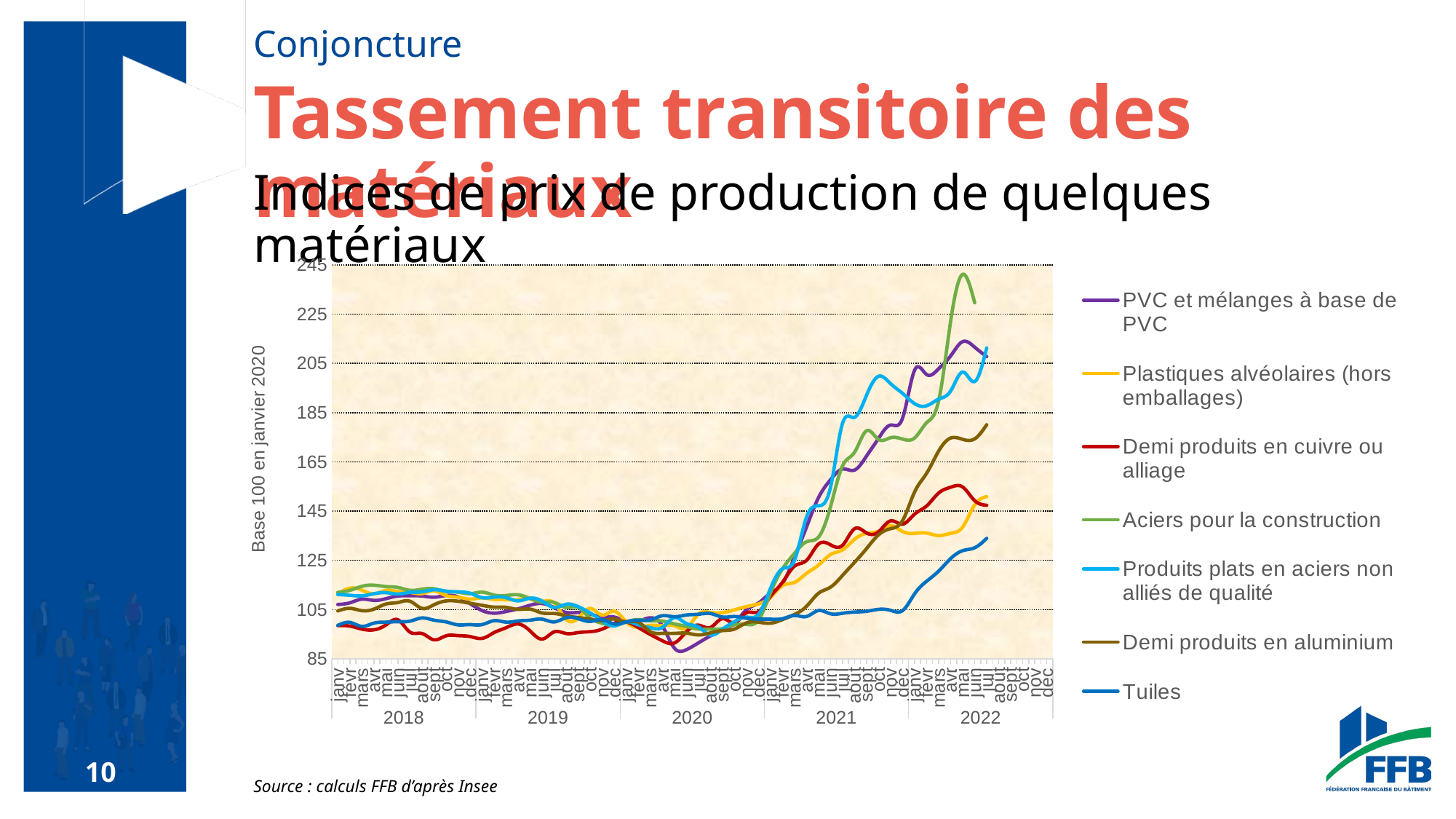
How many series does the legend list? 7 What is the label of the vertical axis? Base 100 en janvier 2020 How many years are labelled on the x axis? 5 Which series is the lowest at the end of the plotted data in 2022? Tuiles What kind of chart is shown on the slide? line chart What is the last entry in the legend? Tuiles Which series reaches the highest value on the chart? Aciers pour la construction Is the value for Tuiles in mid-2022 greater or less than 125? greater Is the peak value of Demi produits en cuivre ou alliage greater or less than 165? less In mid-2022, which is higher: Demi produits en aluminium or Tuiles? Demi produits en aluminium Is the peak value of Aciers pour la construction greater or less than 225? greater Does the Tuiles series rise or fall between the start of 2021 and mid-2022? rise